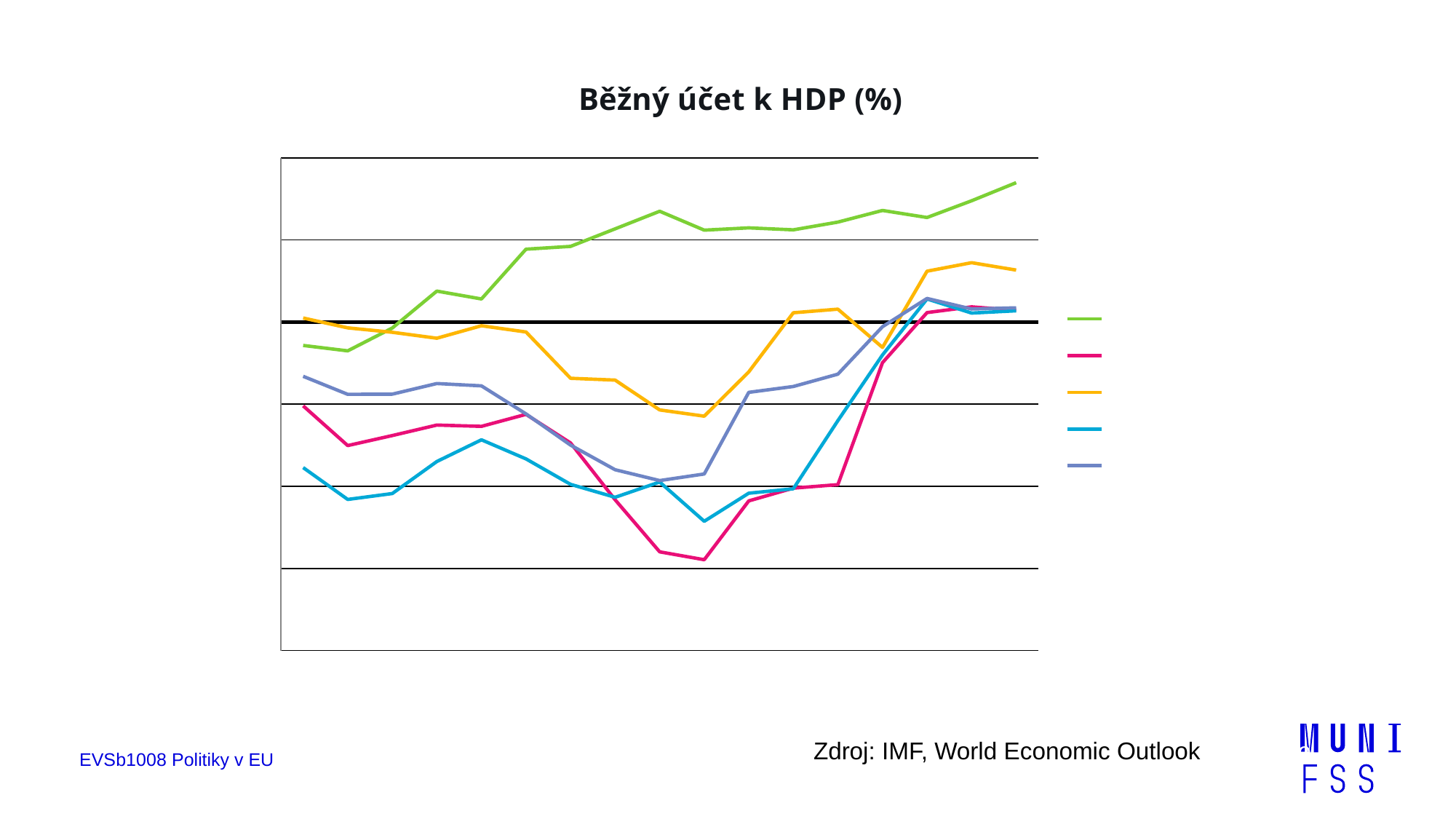
At the right end of the chart, is the green line or the orange line higher? green What is the title of the chart? Běžný účet k HDP (%) How many series does the legend list? 5 What kind of chart is shown on the slide? line chart Which coloured line reaches the lowest point on the chart? pink What is the source cited below the chart? IMF, World Economic Outlook Does the green line generally rise or fall from left to right? rise Which coloured line is the highest at the right end of the chart? green